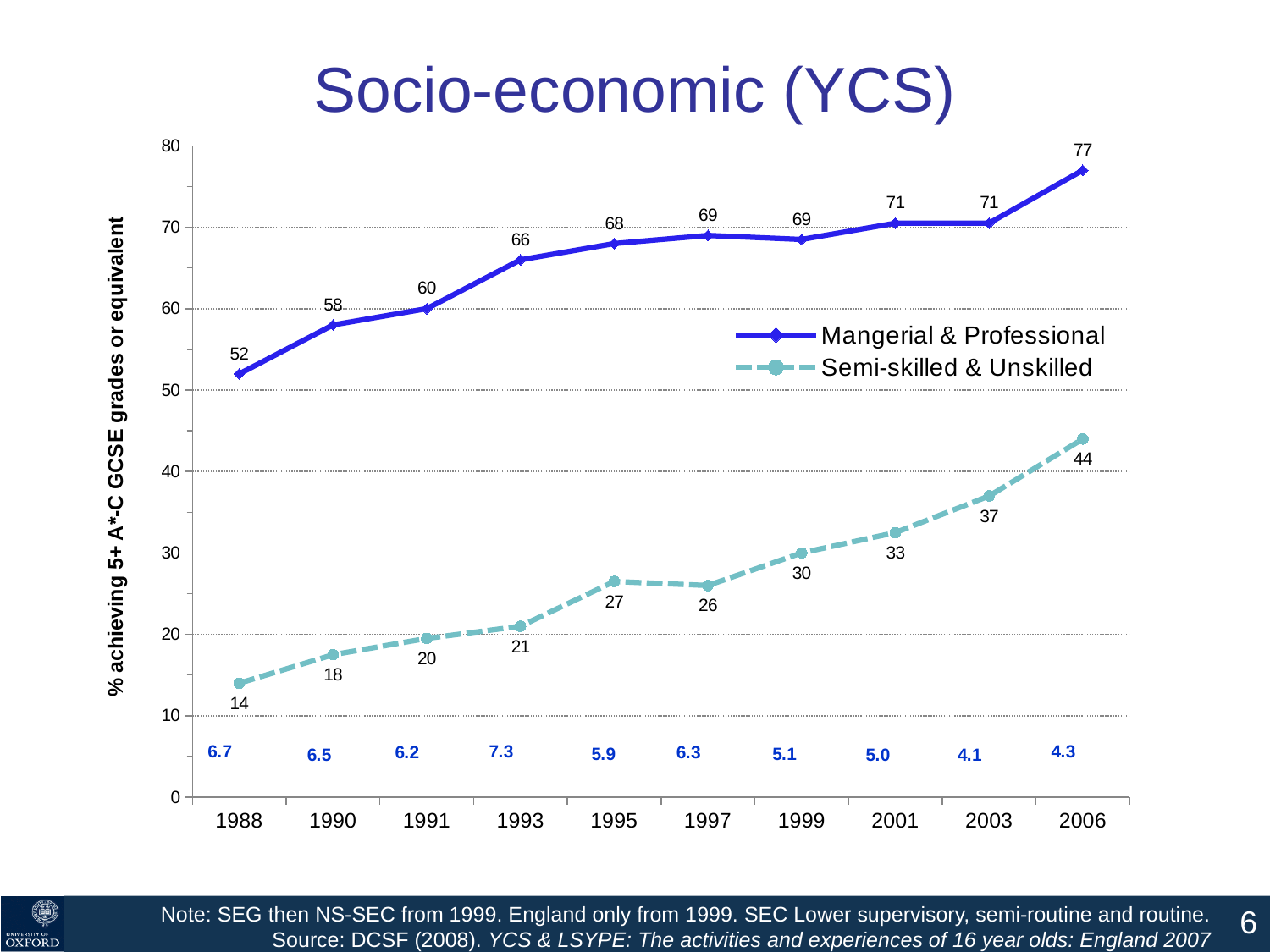
What type of chart is shown on the slide? line chart In which year is the Mangerial & Professional value highest? 2006 What is the value for Mangerial & Professional in 1988? 52 What is the value for Semi-skilled & Unskilled in 2006? 44 What is the label of the y axis? % achieving 5+ A*-C GCSE grades or equivalent What is the value for Semi-skilled & Unskilled in 1995? 27 Does the Semi-skilled & Unskilled series generally rise or fall from 1988 to 2006? rise How many series does the legend list? 2 Which series has the larger value in 1999, Mangerial & Professional or Semi-skilled & Unskilled? Mangerial & Professional What is the difference between the Mangerial & Professional and Semi-skilled & Unskilled values in 2006? 33 In which year is the Semi-skilled & Unskilled value lowest? 1988 How many years are shown on the x axis? 10